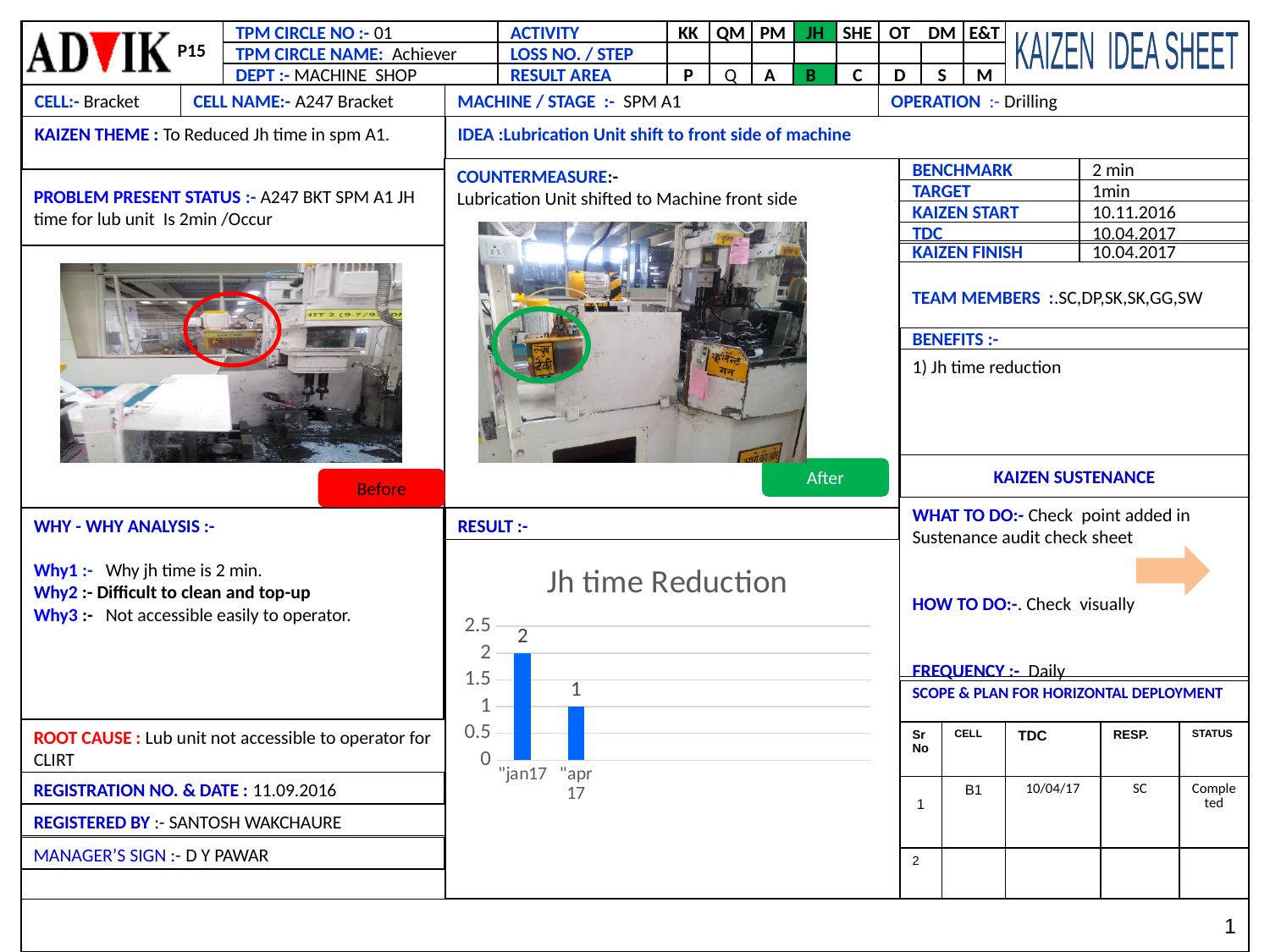
Which is larger in the Jh time Reduction chart, the value for "jan17 or for "apr 17? "jan17 How many bars are plotted in the Jh time Reduction chart? 2 Which category has the highest value in the Jh time Reduction chart? "jan17 What is the difference between the "jan17 and "apr 17 values in the Jh time Reduction chart? 1 What is the maximum value shown on the y axis of the Jh time Reduction chart? 2.5 What is the value for "jan17 in the Jh time Reduction chart? 2 What type of chart is shown under RESULT? bar chart What is the title of the chart on the slide? Jh time Reduction Which category has the lowest value in the Jh time Reduction chart? "apr 17 Is the value for "apr 17 in the Jh time Reduction chart greater or less than 1.5? less What is the value for "apr 17 in the Jh time Reduction chart? 1 Do the values in the Jh time Reduction chart rise or fall from "jan17 to "apr 17? fall